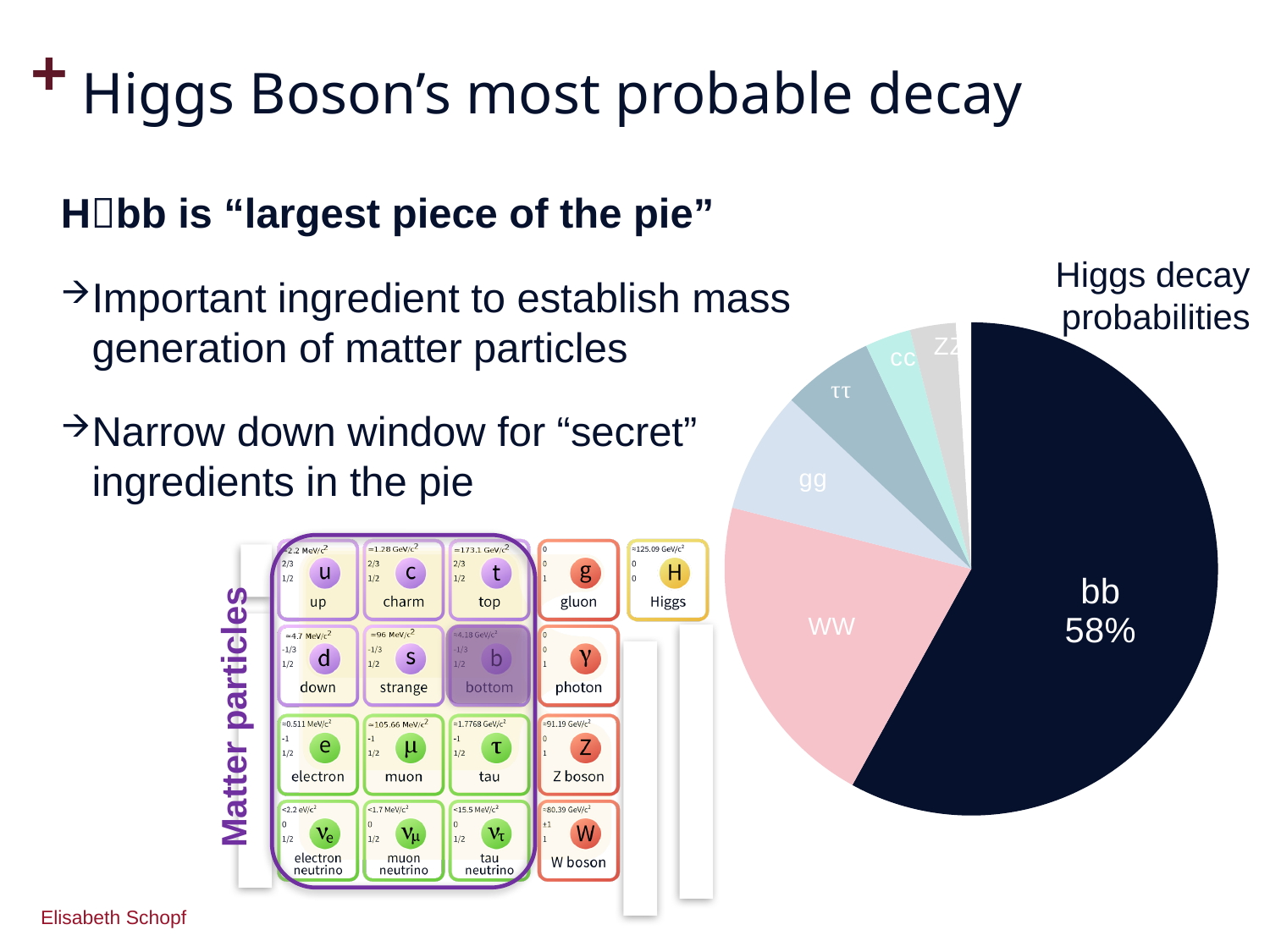
What share of the pie does the bb slice represent? 58% Which decay channel is the second-largest slice in the pie chart? WW Which slice is larger in the pie chart, bb or WW? bb What colour is the bb slice in the Higgs decay probabilities pie chart? dark navy What kind of chart is shown on the slide? pie chart Which decay channel has the largest slice in the Higgs decay probabilities pie chart? bb How many decay channels are labelled in the Higgs decay probabilities pie chart? 6 What is the title of the pie chart? Higgs decay probabilities Which slice is larger in the pie chart, gg or ττ? gg Which slice is larger in the pie chart, WW or gg? WW